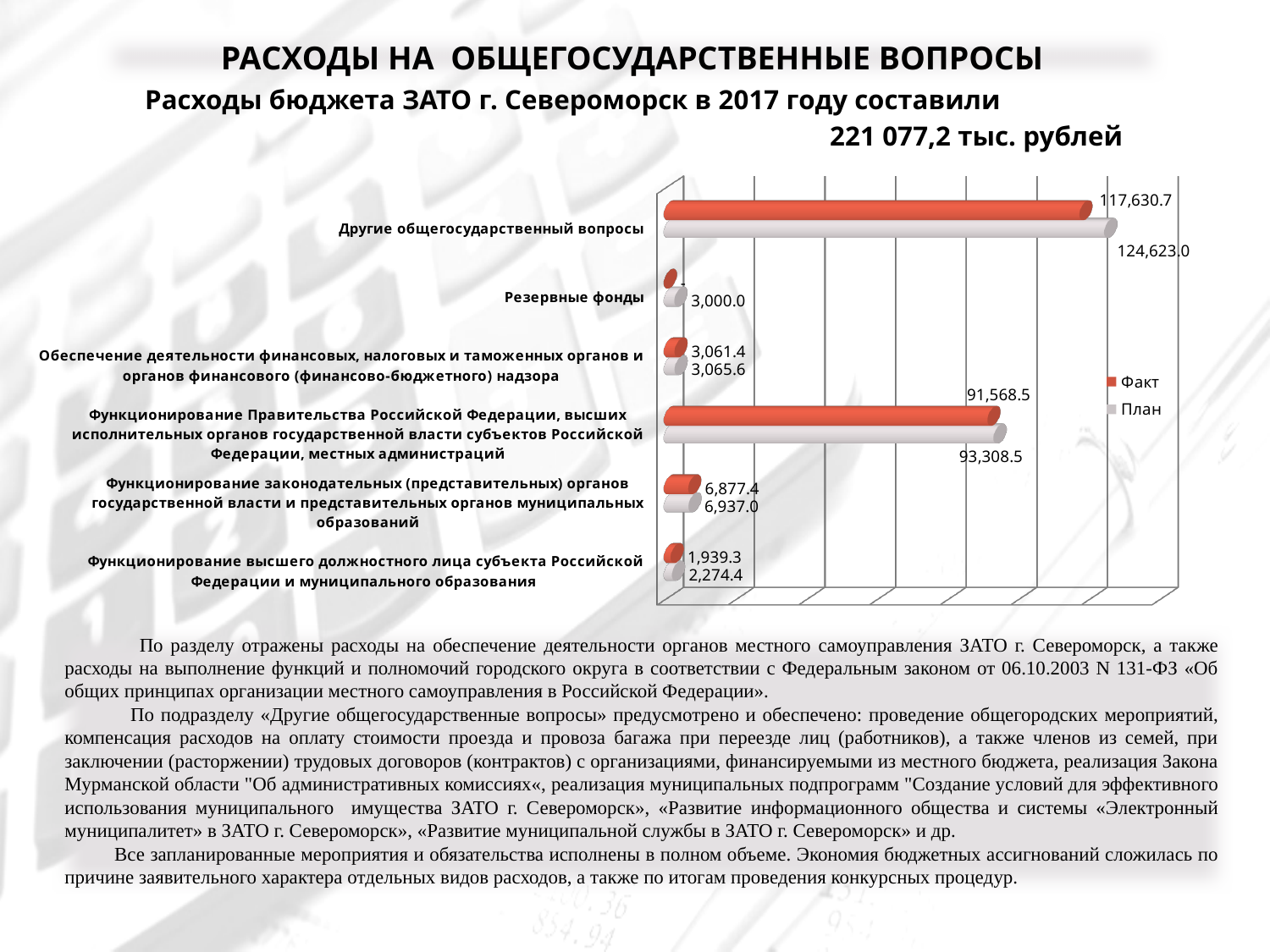
Which is larger for Функционирование высшего должностного лица субъекта Российской Федерации и муниципального образования: the Факт value or the План value? План What is the difference between the План and Факт values for Другие общегосударственный вопросы? 6,992.3 What is the План value for Функционирование законодательных (представительных) органов государственной власти и представительных органов муниципальных образований? 6,937.0 What is the Факт value for Функционирование Правительства Российской Федерации, высших исполнительных органов государственной власти субъектов Российской Федерации, местных администраций? 91,568.5 How many series does the legend list? 2 What is the Факт value for Другие общегосударственный вопросы? 117,630.7 What is the План value for Резервные фонды? 3,000.0 What is the План value for Другие общегосударственный вопросы? 124,623.0 What kind of chart is shown on the slide? Bar chart Which category has the highest Факт value? Другие общегосударственный вопросы How many categories are shown on the chart? 6 What is the Факт value for Функционирование высшего должностного лица субъекта Российской Федерации и муниципального образования? 1,939.3